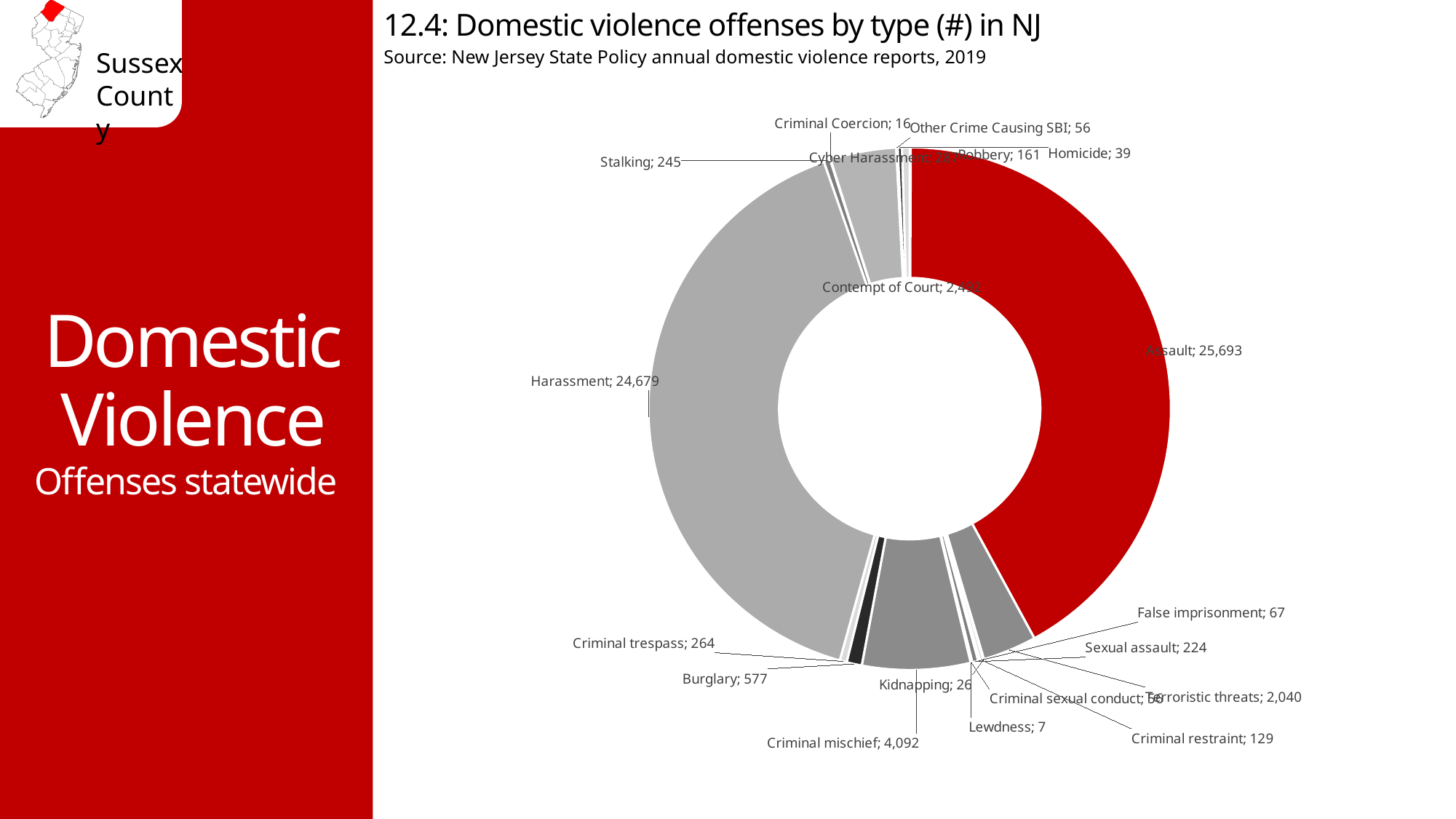
What is the source cited for the chart? New Jersey State Policy annual domestic violence reports, 2019 What is the number of Assault offenses shown in the chart? 25,693 What is the difference between the Burglary and Criminal trespass values? 313 Which is larger, the value for Stalking or the value for Sexual assault? Stalking What is the value shown for Homicide? 39 What is the value shown for Criminal mischief? 4,092 What kind of chart is shown on the slide? Pie chart (doughnut) What is the number of Harassment offenses shown in the chart? 24,679 What is the value shown for Terroristic threats? 2,040 What is the difference between the Assault and Harassment values? 1,014 Which offense type has the smallest value shown in the chart? Lewdness Which offense type has the largest slice in the chart? Assault